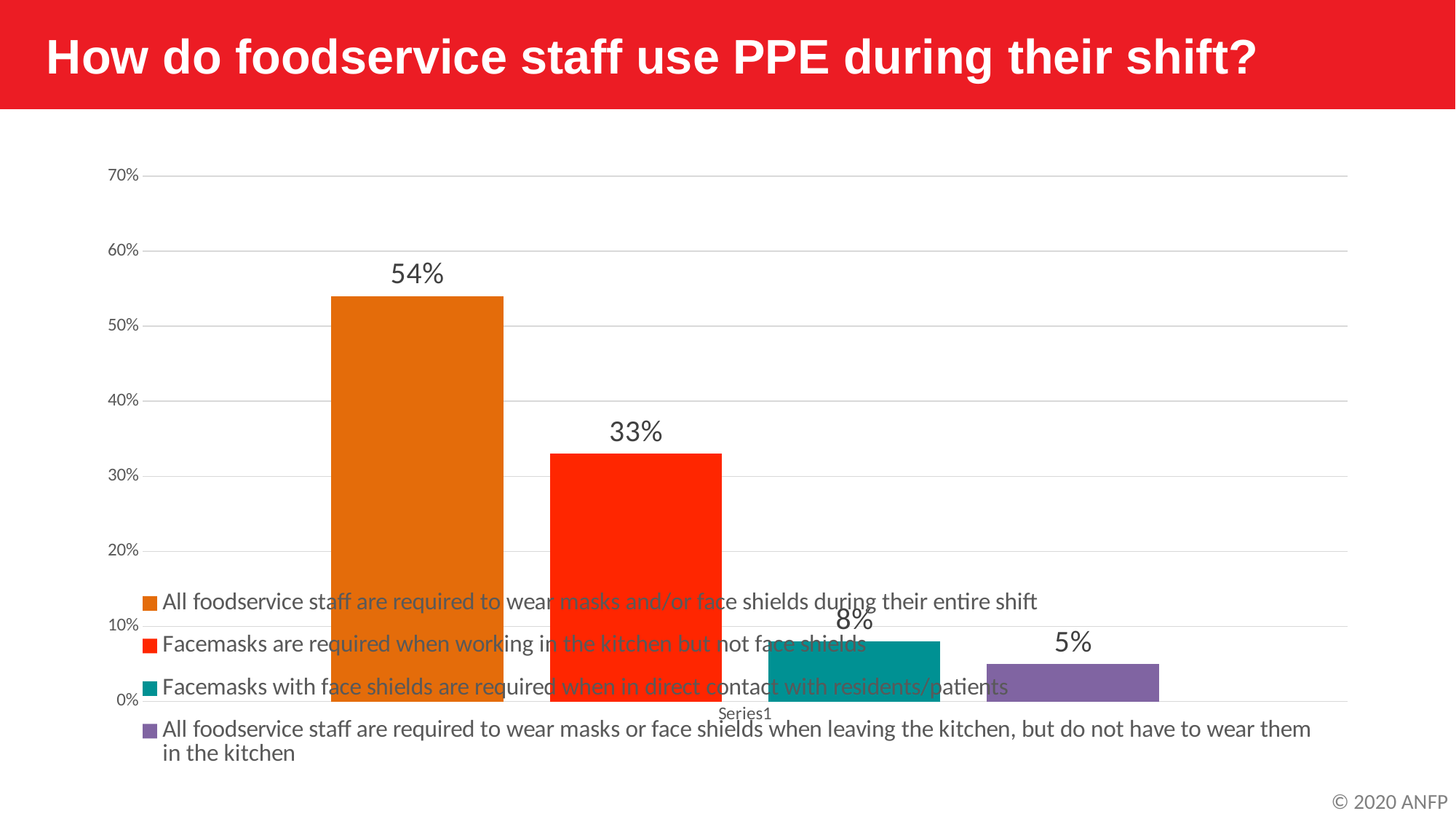
What is the difference in percentage points between the 'entire shift' response and the 'kitchen but not face shields' response? 21 What type of chart is shown on the slide? Bar chart What is the title of the slide? How do foodservice staff use PPE during their shift? How many entries does the legend list? 4 Which is larger: the percentage for facemasks with face shields when in direct contact with residents/patients, or the percentage for masks required only when leaving the kitchen? Facemasks with face shields are required when in direct contact with residents/patients What percentage of respondents said all foodservice staff are required to wear masks and/or face shields during their entire shift? 54% How many bars are shown in the chart? 4 Which response has the lowest percentage? All foodservice staff are required to wear masks or face shields when leaving the kitchen, but do not have to wear them in the kitchen What percentage of respondents said staff are required to wear masks or face shields when leaving the kitchen, but not in the kitchen? 5% What percentage of respondents said facemasks are required when working in the kitchen but not face shields? 33% Which response has the highest percentage? All foodservice staff are required to wear masks and/or face shields during their entire shift What percentage of respondents said facemasks with face shields are required when in direct contact with residents/patients? 8%